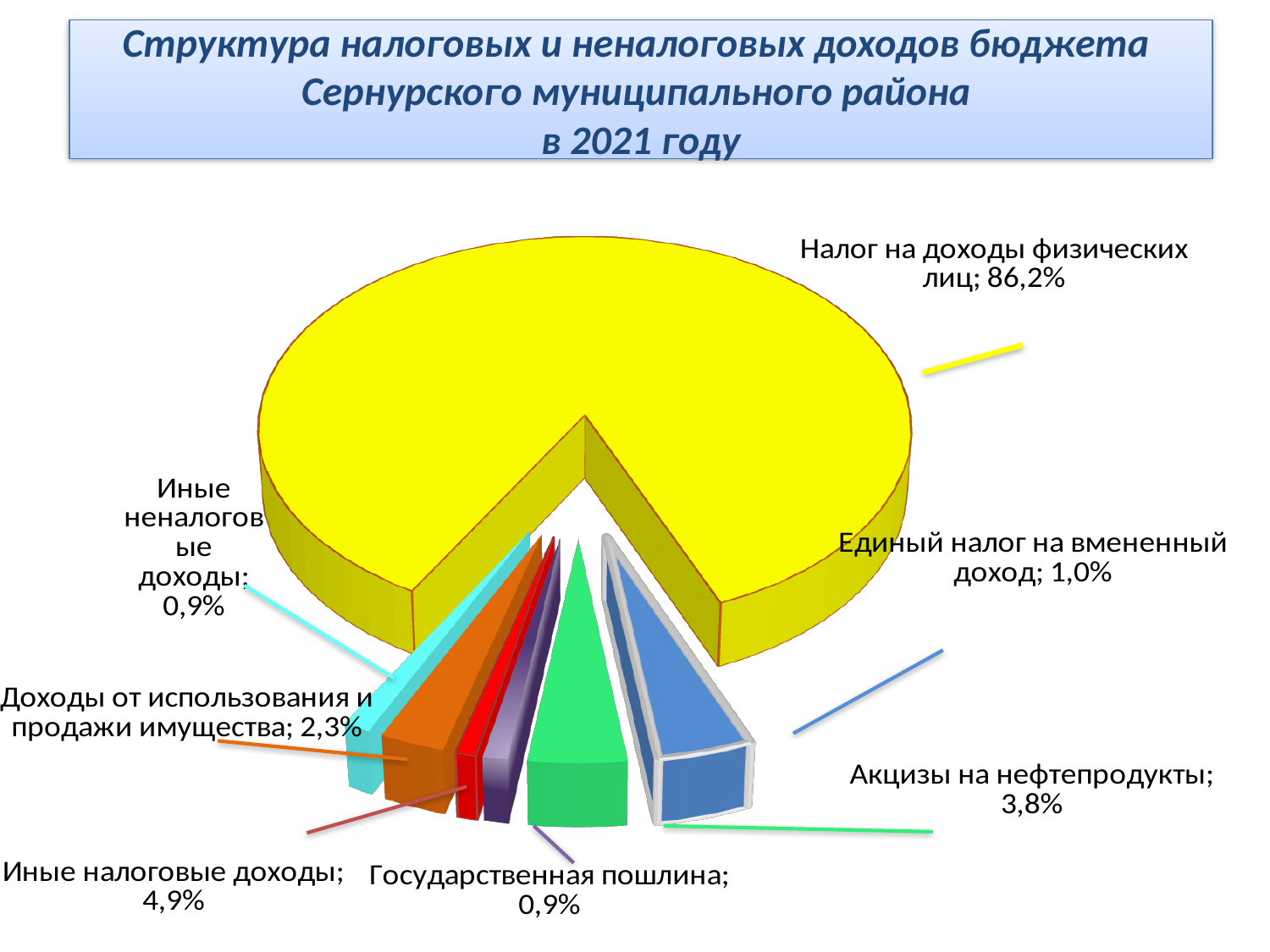
What kind of chart is shown on the slide? Pie chart What colour is the slice for Налог на доходы физических лиц? Yellow What is the value for Единый налог на вмененный доход? 1,0% How many categories (slices) does the pie chart show? 7 Which category has the largest share of the pie? Налог на доходы физических лиц What share is labelled for Доходы от использования и продажи имущества? 2,3% What share of the pie does Налог на доходы физических лиц have? 86,2% What percentage is shown for Иные налоговые доходы? 4,9% What is the difference in percentage points between Акцизы на нефтепродукты and Единый налог на вмененный доход? 2,8 Which is larger: Иные налоговые доходы or Акцизы на нефтепродукты? Иные налоговые доходы What is the value shown for Акцизы на нефтепродукты? 3,8% What is the difference in percentage points between Иные налоговые доходы and Доходы от использования и продажи имущества? 2,6